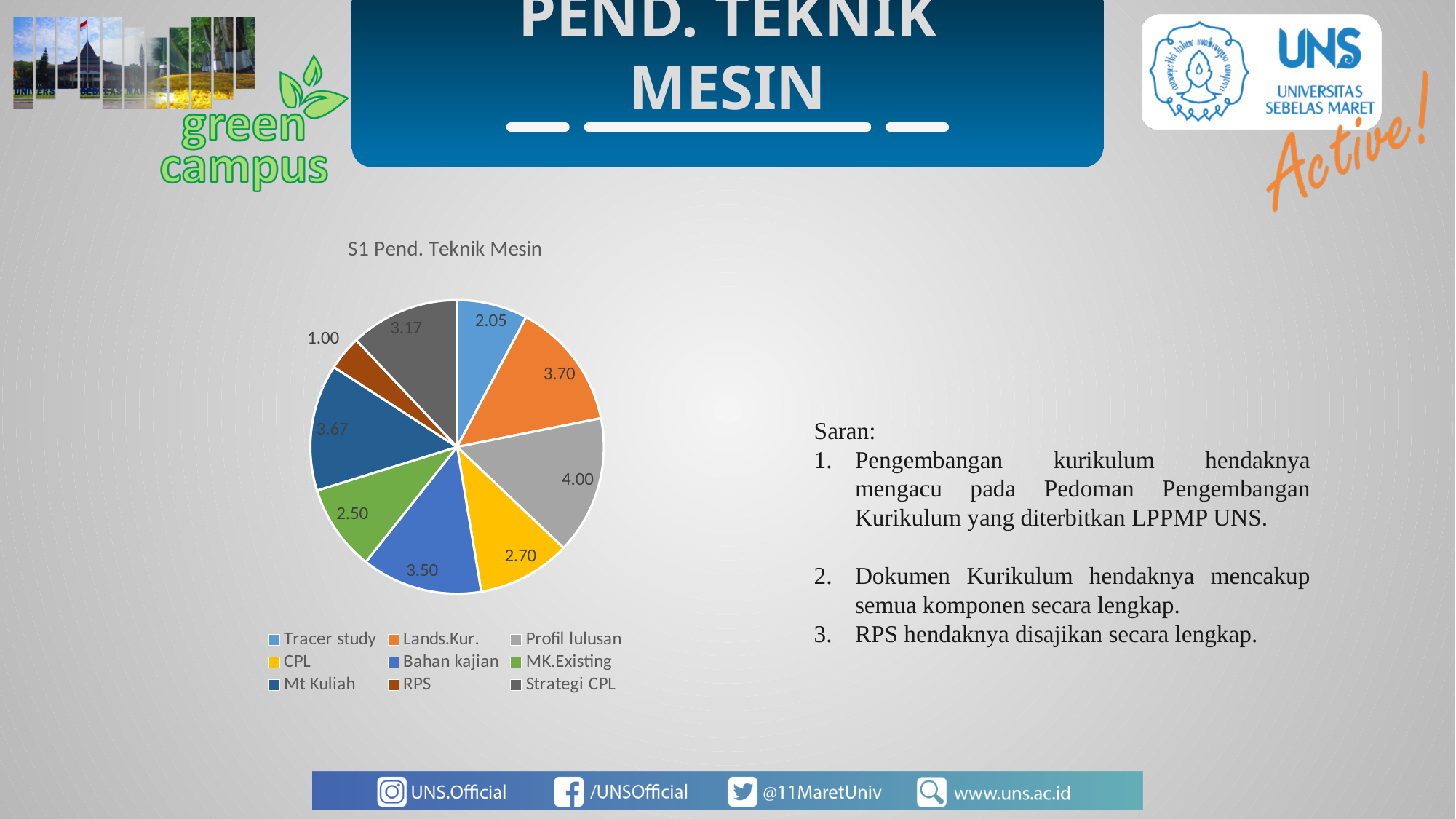
Which is larger, the value for Bahan kajian or the value for CPL? Bahan kajian What is the value for Strategi CPL? 3.17 What is the difference between the values for Lands.Kur. and Tracer study? 1.65 How many categories does the pie chart have? 9 What is the difference between the values for Profil lulusan and RPS? 3.00 Which category has the lowest value? RPS What is the value for MK.Existing? 2.50 What type of chart is shown on the slide? Pie chart What is the value for Tracer study? 2.05 Which category has the highest value? Profil lulusan What is the title of the chart? S1 Pend. Teknik Mesin What is the value for Profil lulusan? 4.00